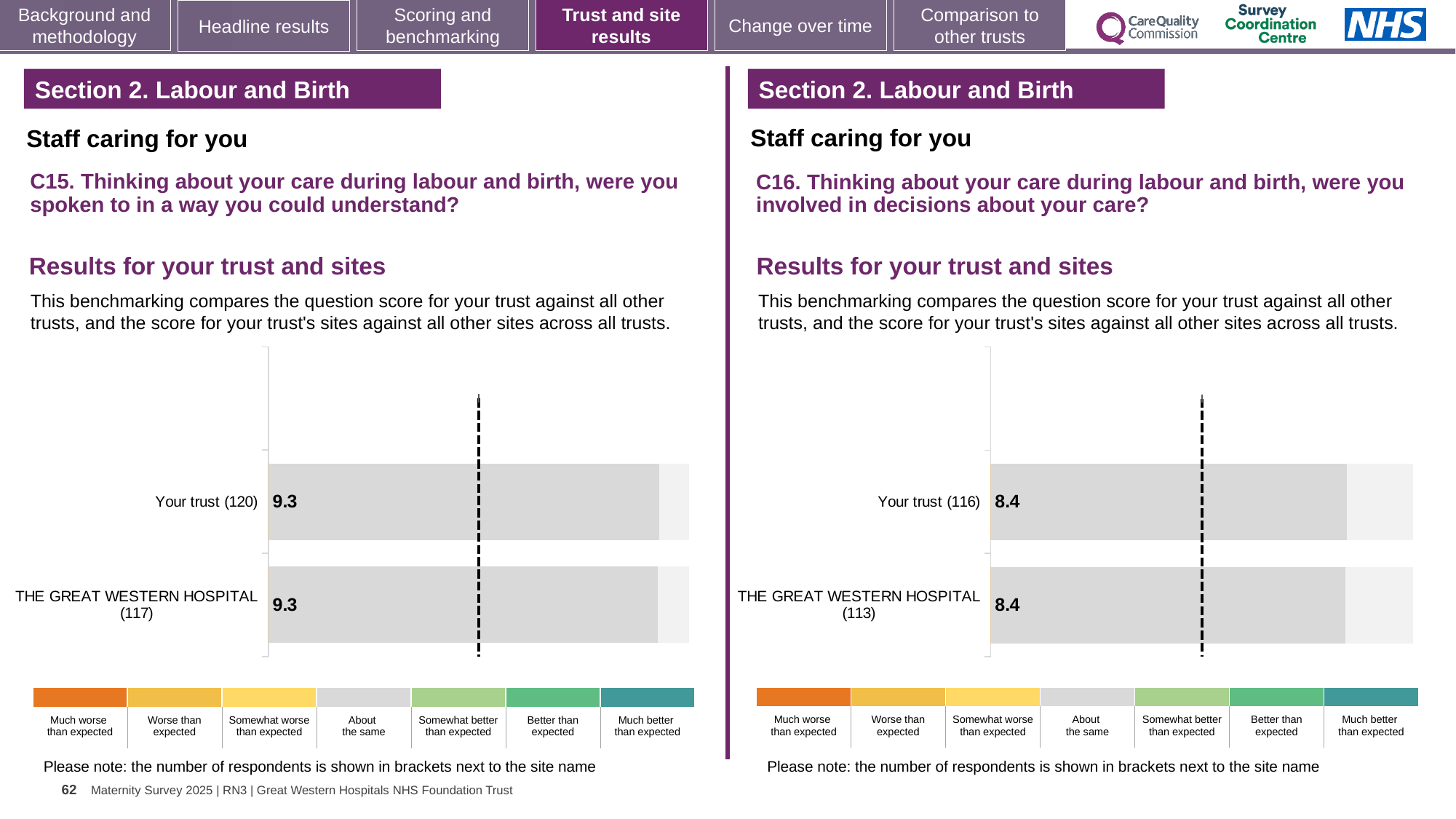
On the C15 chart (left), how many respondents are shown in brackets for Your trust? 120 On the C16 chart (right), what is the difference between the Your trust score and THE GREAT WESTERN HOSPITAL score? 0.0 On the C15 chart (left), what is the score for THE GREAT WESTERN HOSPITAL? 9.3 On the C16 chart (right), how many respondents are shown in brackets for THE GREAT WESTERN HOSPITAL? 113 How many bars are plotted on the C16 chart (right)? 2 On the C15 chart (left), what is the difference between the Your trust score and THE GREAT WESTERN HOSPITAL score? 0.0 On the C16 chart (right), what is the score for Your trust? 8.4 On the C15 chart (left), what is the score for Your trust? 9.3 How many bars are plotted on the C15 chart (left)? 2 On the C16 chart (right), what is the score for THE GREAT WESTERN HOSPITAL? 8.4 What type of chart is used on the C15 chart (left)? Bar chart Is the Your trust score on the C15 chart (left) larger or smaller than the Your trust score on the C16 chart (right)? Larger